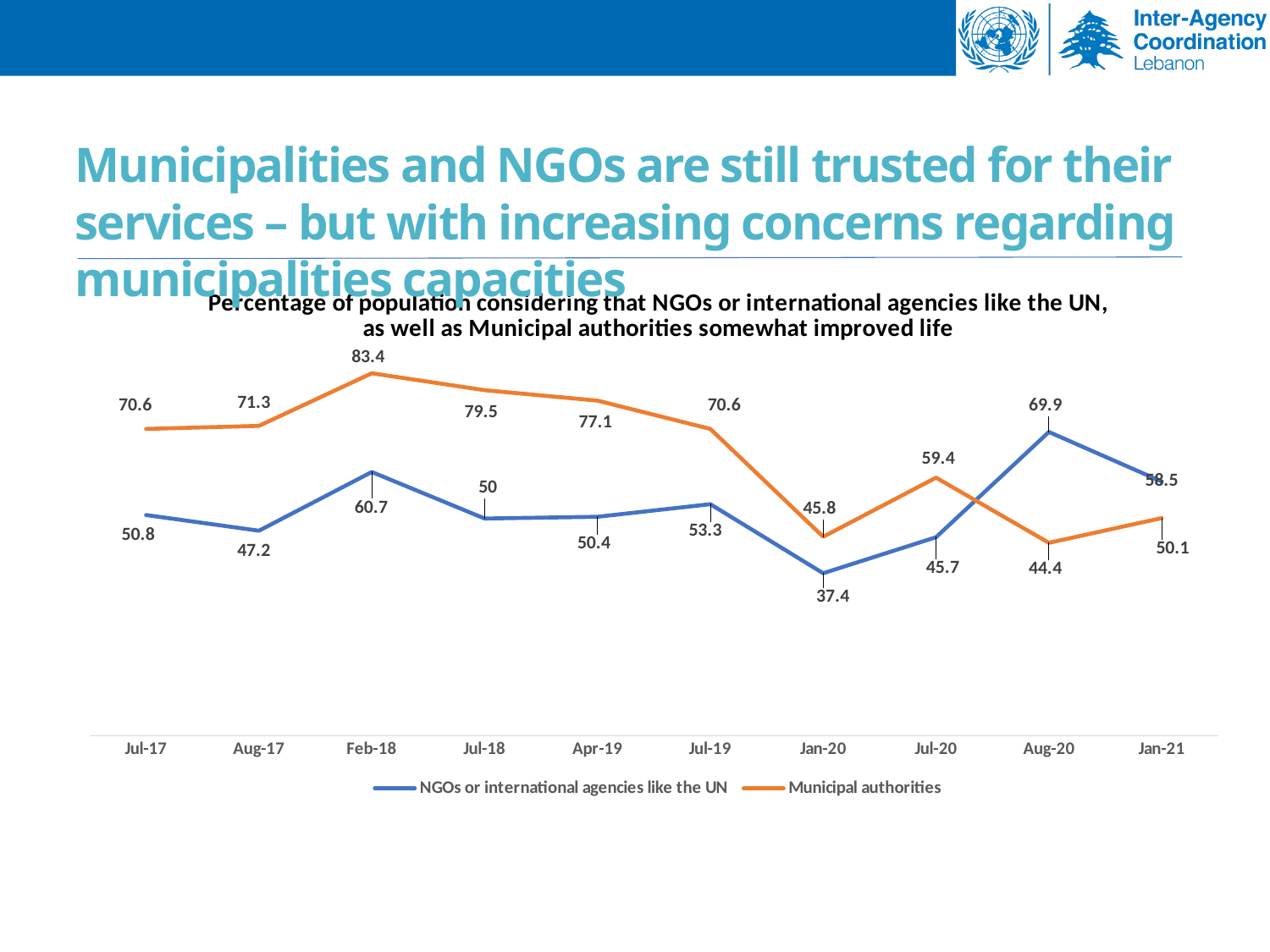
At which time point is the value for NGOs or international agencies like the UN highest? Aug-20 Which colour is used for the Municipal authorities line? Orange What type of chart is shown on the slide? Line chart At which time point is the value for Municipal authorities lowest? Aug-20 How many series does the legend list? 2 In Jan-21, which series has the larger value: NGOs or international agencies like the UN, or Municipal authorities? NGOs or international agencies like the UN What is the value for Municipal authorities in Aug-20? 44.4 Does the value for Municipal authorities rise or fall from Feb-18 to Jul-19? Fall How many time points are shown on the x axis? 10 What is the difference between Municipal authorities and NGOs or international agencies like the UN in Jul-17? 19.8 What is the value for NGOs or international agencies like the UN in Jan-20? 37.4 What is the value for Municipal authorities in Feb-18? 83.4